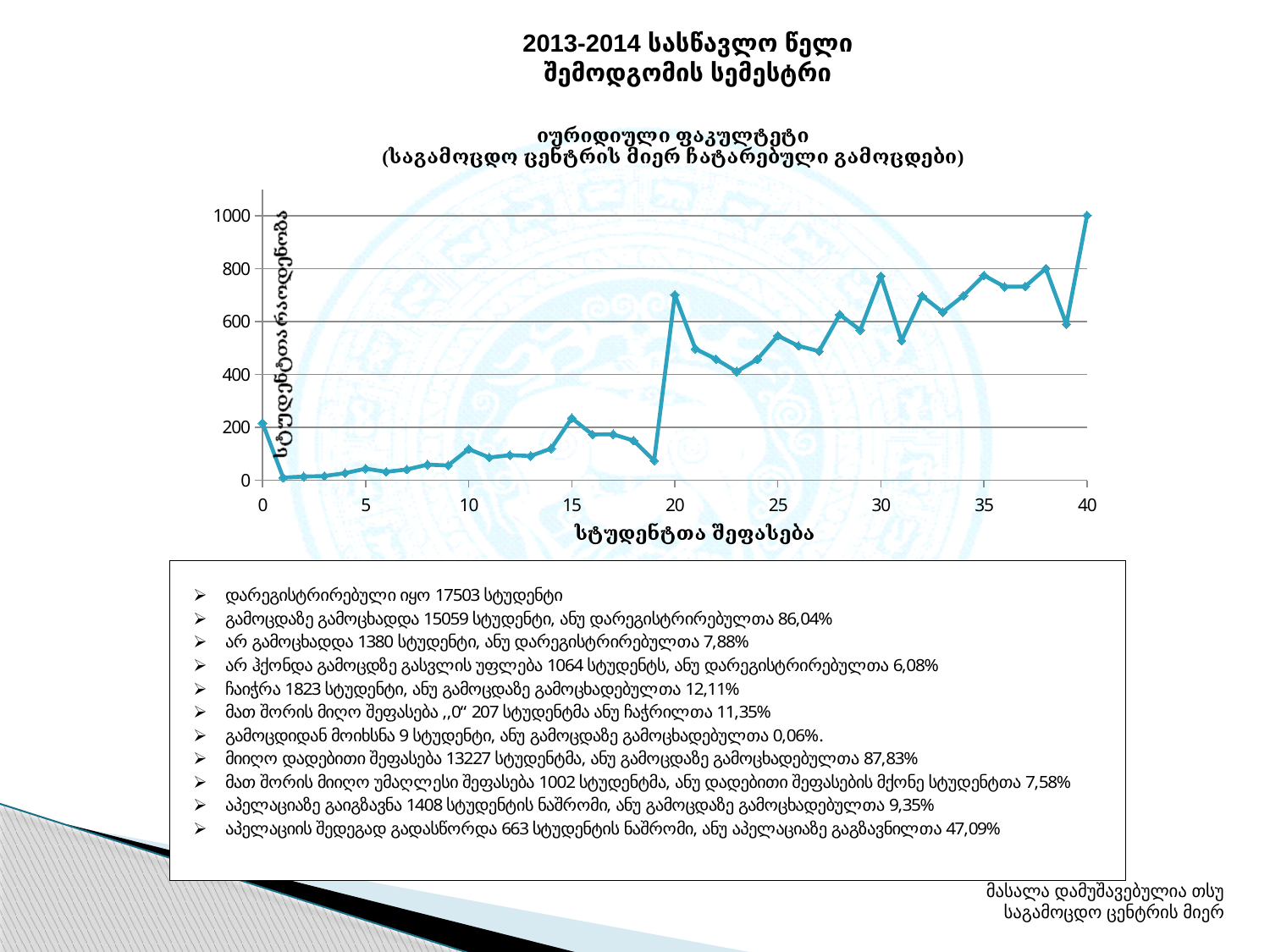
Which has the larger number of students: score 20 or score 10? score 20 Is the value at score 40 greater or less than 800? greater Does the line rise or fall between score 19 and score 20? rise At which score on the x axis does the line reach its highest value? 40 What is the label of the horizontal axis of the chart? სტუდენტთა შეფასება What is the label of the vertical axis of the chart? სტუდენტთა რაოდენობა Is the value at score 30 greater or less than 600? greater What type of chart is shown on the slide? line chart Is the value at score 15 greater or less than 400? less